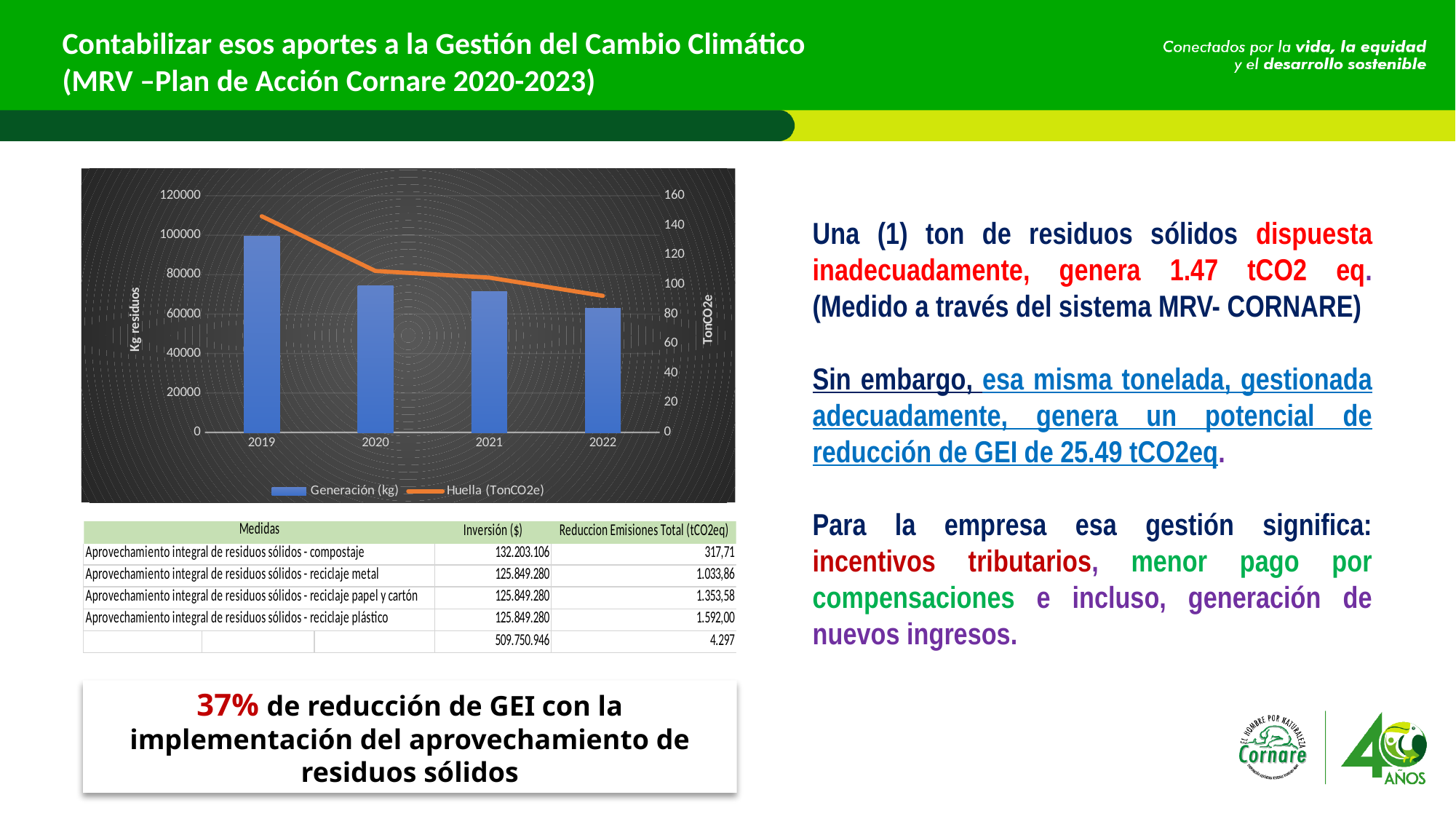
How many series does the chart legend list? 2 How many years are shown on the x axis of the chart? 4 Which year has the lowest Generación (kg) bar? 2022 Is the Generación (kg) value for 2019 greater or less than 80000? greater What is the title of the left vertical axis of the chart? Kg residuos Is the Generación (kg) value for 2022 greater or less than 80000? less Does the Huella (TonCO2e) line rise or fall from 2019 to 2022? fall Which year has the highest Generación (kg) bar? 2019 What kind of chart is shown on the slide? bar chart with a line Is the Huella (TonCO2e) value for 2019 greater or less than 120? greater Do the Generación (kg) bars rise or fall from 2019 to 2022? fall Which year has a larger Generación (kg) bar, 2019 or 2022? 2019